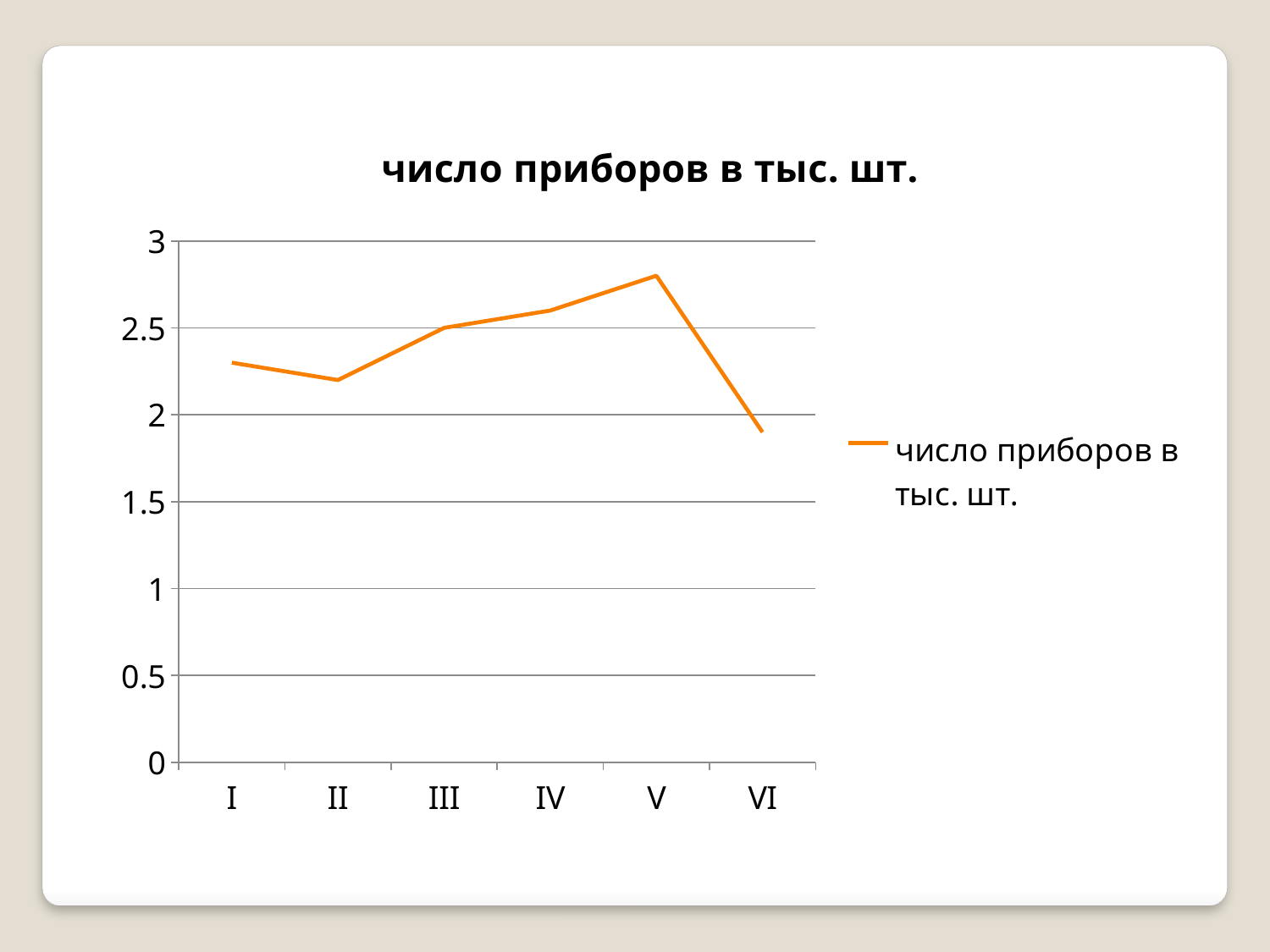
Which is larger, the value for V or the value for VI? V How many categories are shown on the x axis? 6 What kind of chart is shown on the slide? line chart Which category has the lowest value? VI Is the value for V greater or less than 2.5? greater Is the value for VI greater or less than 2? less Which category has the highest value? V What is the title of the chart? число приборов в тыс. шт. What is the value for category III? 2.5 Is the value for II greater or less than 2? greater How many series does the legend list? 1 Do the values rise or fall from II to V? rise